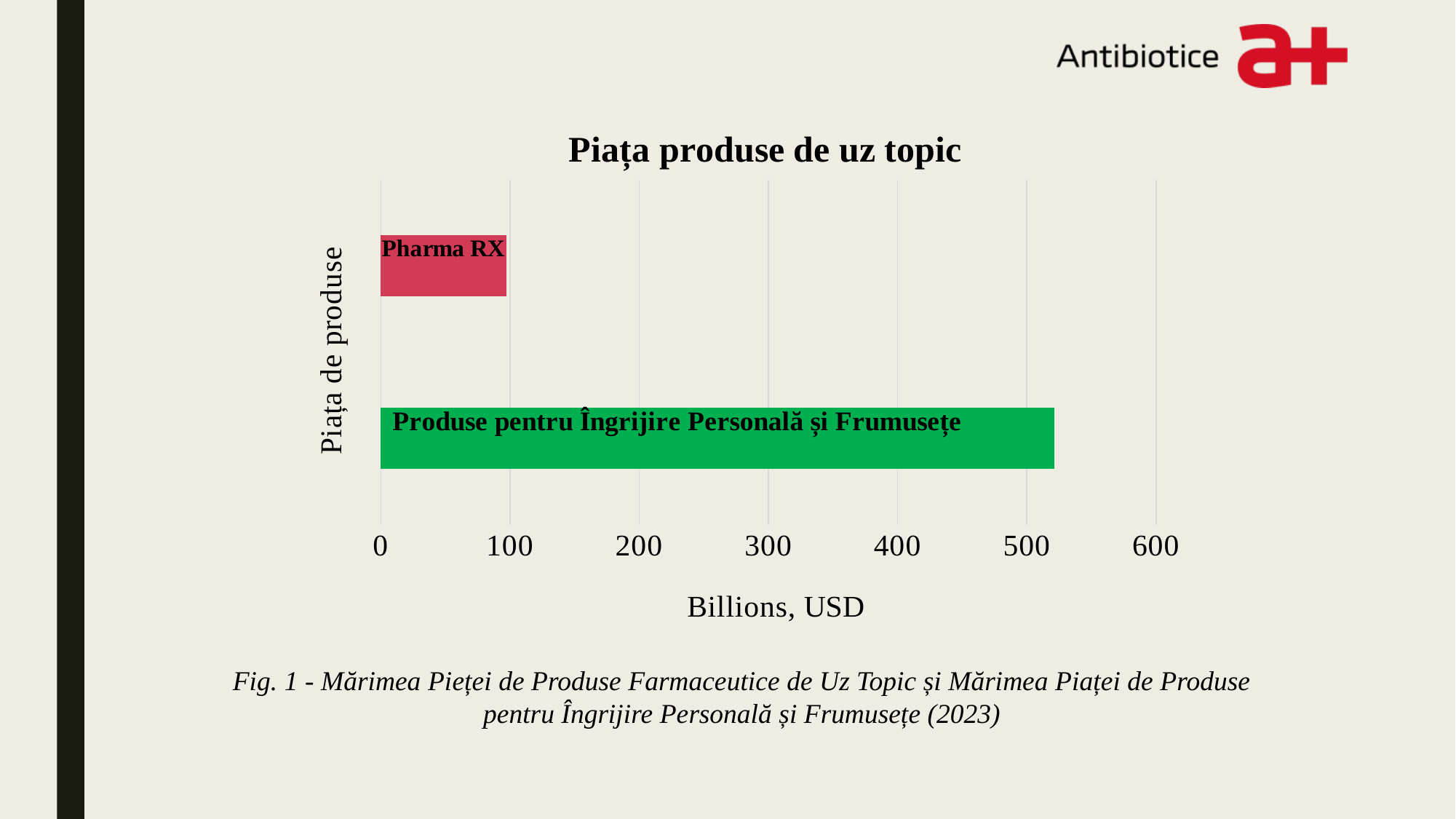
Which is larger, the value for Pharma RX or the value for Produse pentru Îngrijire Personală și Frumusețe? Produse pentru Îngrijire Personală și Frumusețe What is the title of the chart? Piața produse de uz topic Which category has the lowest value? Pharma RX How many bars (categories) does the chart show? 2 Is the value for Pharma RX greater or less than 300? less Is the value for Pharma RX greater or less than 200? less What kind of chart is shown on the slide? bar chart Is the value for Produse pentru Îngrijire Personală și Frumusețe greater or less than 600? less Which category has the highest value? Produse pentru Îngrijire Personală și Frumusețe What unit is shown on the horizontal axis label? Billions, USD